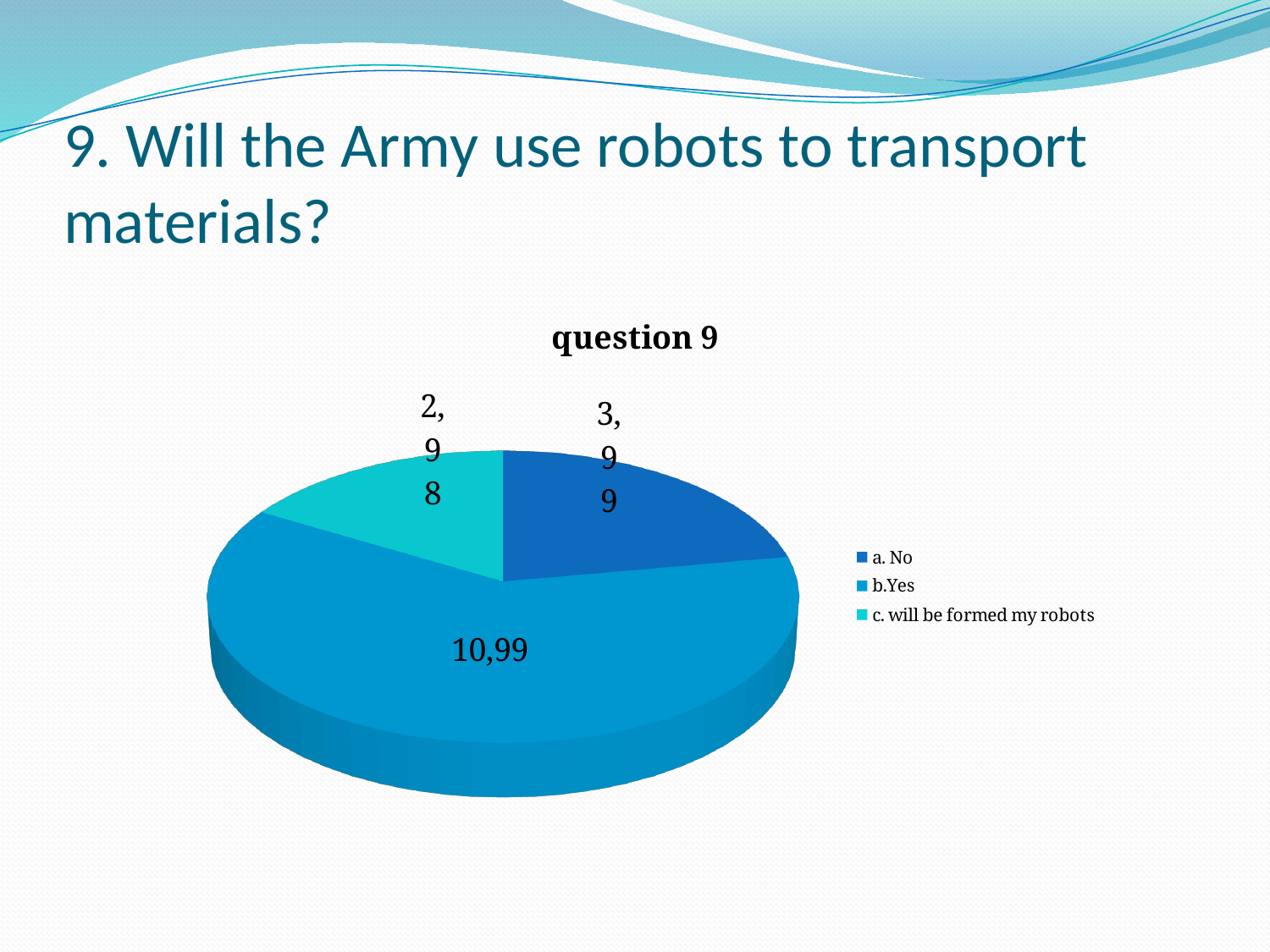
Which category has the smallest slice of the pie? c. will be formed my robots Which category has the largest slice of the pie? b.Yes How many entries does the legend list? 3 Which legend entry is shown in the darkest blue colour? a. No What is the title of the chart? question 9 What is the value shown for b.Yes? 10,99 Which is larger, the value for a. No or the value for b.Yes? b.Yes How many slices does the pie chart have? 3 What kind of chart is shown on the slide? pie chart What is the value shown for a. No? 3,99 What is the difference between the value for b.Yes and the value for a. No? 7 What is the value shown for c. will be formed my robots? 2,98